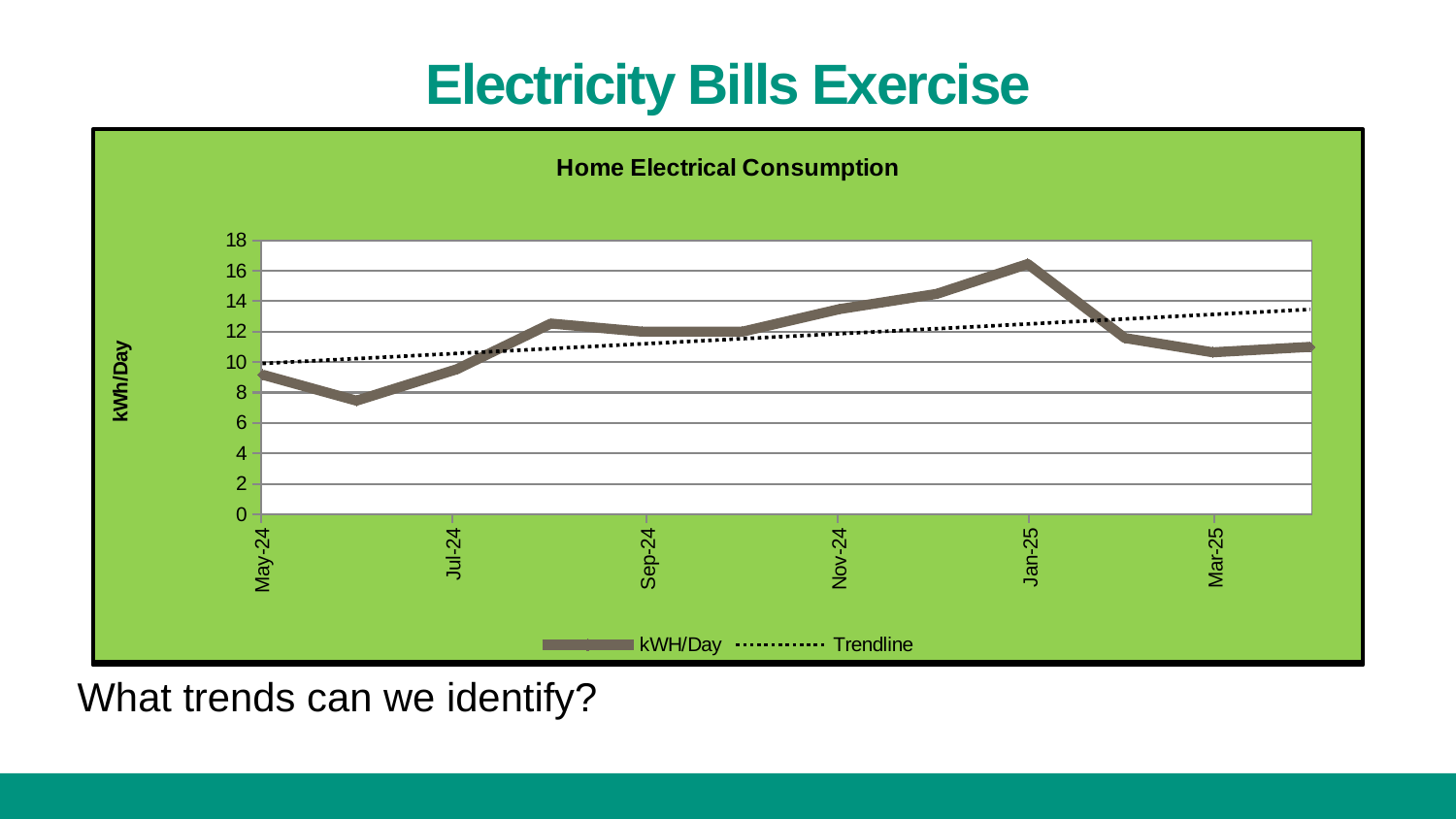
What is the title of the chart? Home Electrical Consumption Is the kWH/Day value for Mar-25 greater or less than 12? less Which is larger, the kWH/Day value for Jan-25 or for Mar-25? Jan-25 What is the label on the vertical axis? kWh/Day Is the kWH/Day value for Nov-24 greater or less than 12? greater Does the Trendline rise or fall from left to right? rise How many series does the legend list? 2 Is the kWH/Day value for Jan-25 greater or less than 14? greater How many month labels are shown on the x axis? 6 Among the labelled months, which has the highest kWH/Day value? Jan-25 What kind of chart is shown on the slide? line chart